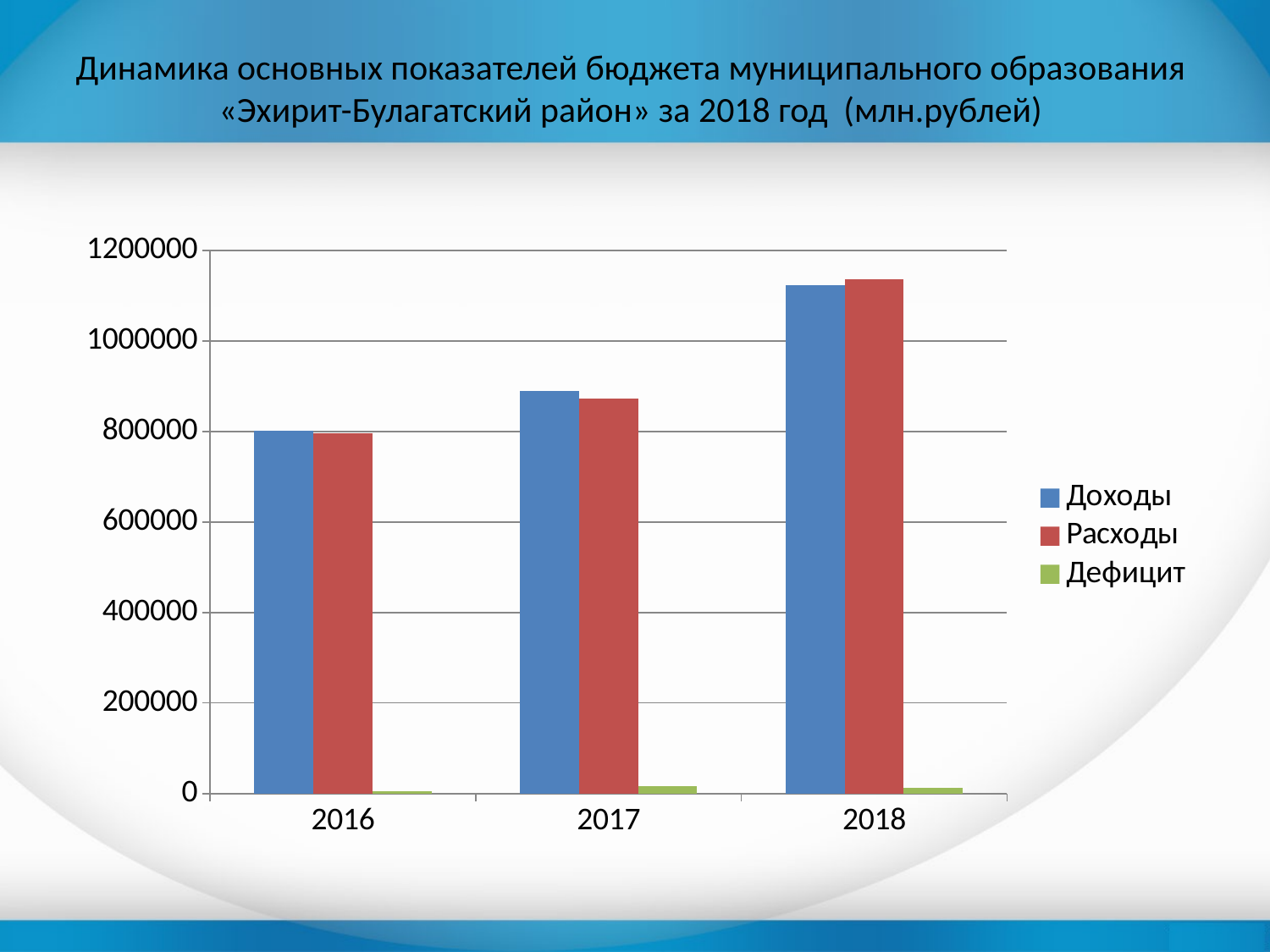
In 2018, which is larger, Доходы or Расходы? Расходы How many series does the legend list? 3 In which year is Доходы lowest? 2016 Is the value for Расходы in 2017 greater or less than 1000000? less Do the Расходы values rise or fall from 2016 to 2018? rise In which year is Дефицит highest? 2017 Is the value for Доходы in 2018 greater or less than 1000000? greater What kind of chart is shown on the slide? bar chart How many years are shown on the x axis? 3 Is the value for Дефицит in 2017 greater or less than 200000? less In which year is Доходы highest? 2018 Which series are listed in the legend? Доходы, Расходы, Дефицит